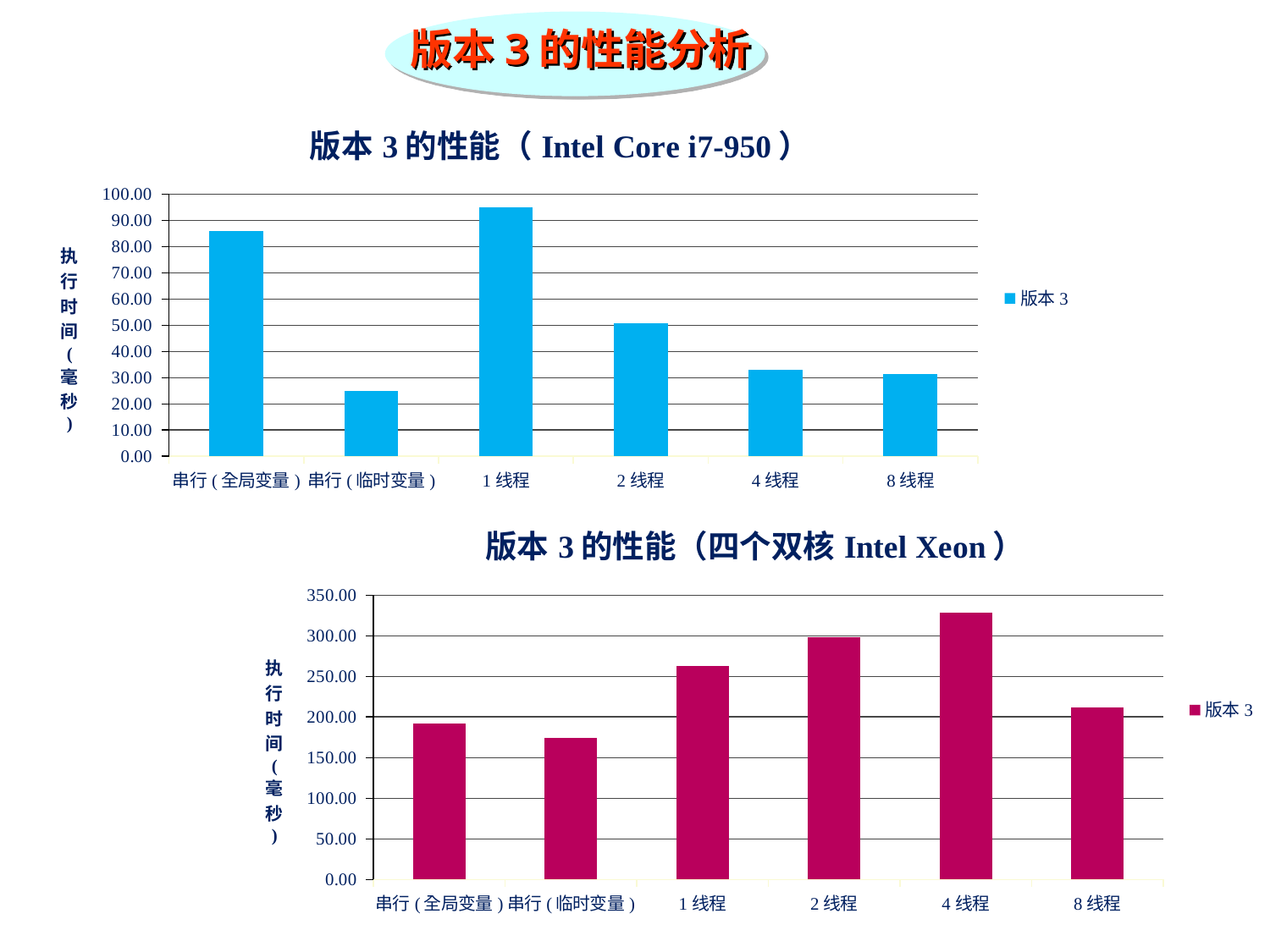
In the bottom chart (四个双核 Intel Xeon), is the value for 4 线程 greater or less than 300? greater What kind of chart is the top chart titled 版本 3 的性能 (Intel Core i7-950)? bar chart In the bottom chart (四个双核 Intel Xeon), which category has the lowest execution time? 串行 (临时变量) In the bottom chart (四个双核 Intel Xeon), which category has the highest execution time? 4 线程 In the top chart (Intel Core i7-950), is the value for 串行 (全局变量) greater or less than 80? greater How many series does the legend of the bottom chart (四个双核 Intel Xeon) list? 1 In the top chart (Intel Core i7-950), which category has the highest execution time? 1 线程 In the top chart (Intel Core i7-950), is the value for 4 线程 greater or less than 40? less What is the legend entry shown in the top chart (Intel Core i7-950)? 版本 3 In the top chart (Intel Core i7-950), which category has the lowest execution time? 串行 (临时变量) How many categories are shown on the x axis of the top chart (Intel Core i7-950)? 6 In the top chart (Intel Core i7-950), which is larger, the value for 2 线程 or the value for 8 线程? 2 线程